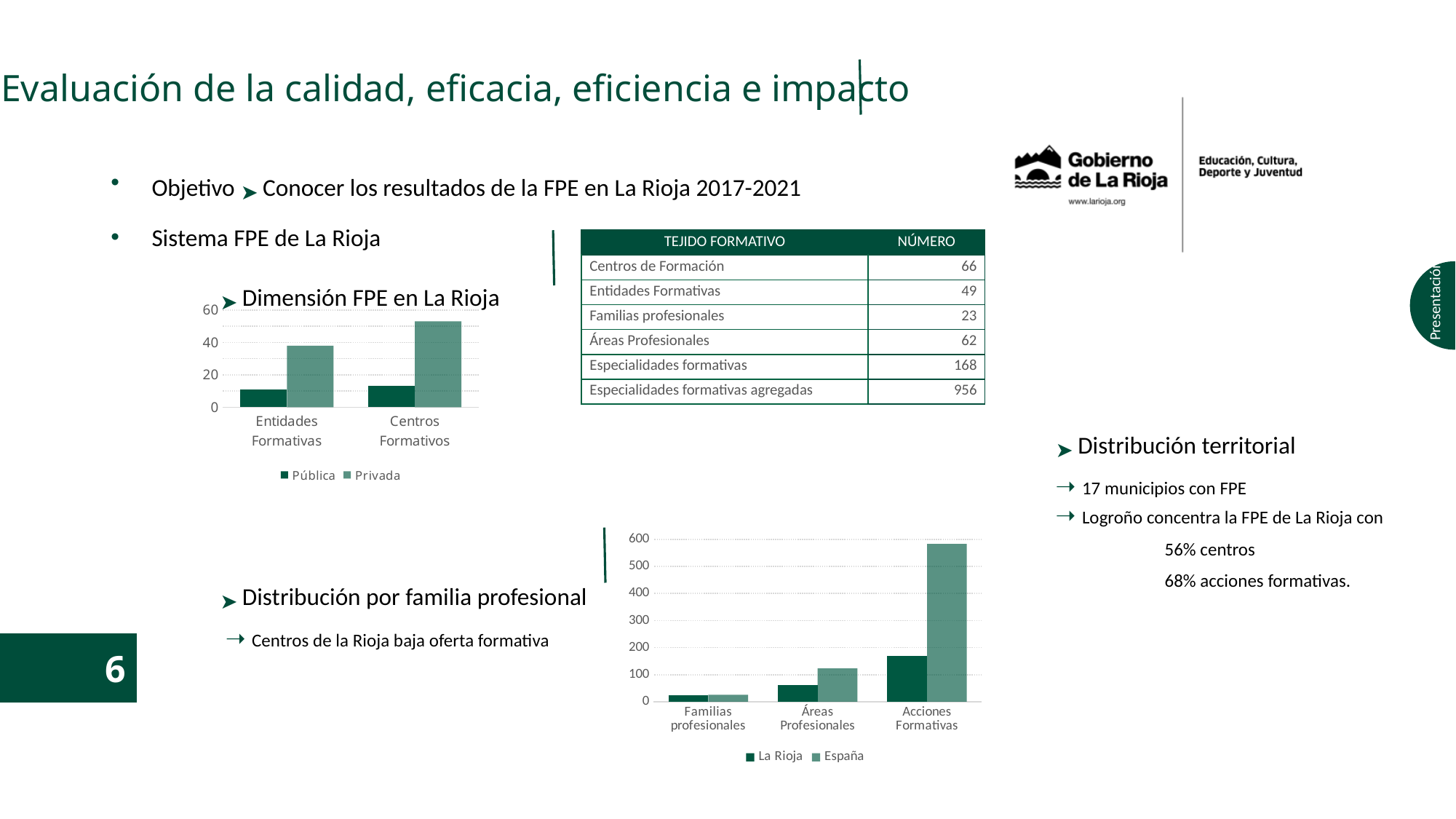
In the bottom chart (La Rioja vs España), which category has the lowest La Rioja bar? Familias profesionales How many series does the legend of the 'Dimensión FPE en La Rioja' chart list? 2 What are the two series listed in the legend of the bottom chart (La Rioja vs España)? La Rioja and España How many categories are shown on the x axis of the bottom chart (La Rioja vs España)? 3 In the bottom chart (La Rioja vs España), is the España value for Acciones Formativas greater or less than 500? greater In the 'Dimensión FPE en La Rioja' chart, which series is larger for Centros Formativos, Pública or Privada? Privada In the bottom chart (La Rioja vs España), which category has the highest España bar? Acciones Formativas What kind of chart is the 'Dimensión FPE en La Rioja' chart? bar chart In the 'Dimensión FPE en La Rioja' chart, is the Privada value for Centros Formativos greater or less than 40? greater In the bottom chart (La Rioja vs España), is the La Rioja value for Acciones Formativas greater or less than 200? less In the 'Dimensión FPE en La Rioja' chart, which category has the highest Privada bar? Centros Formativos